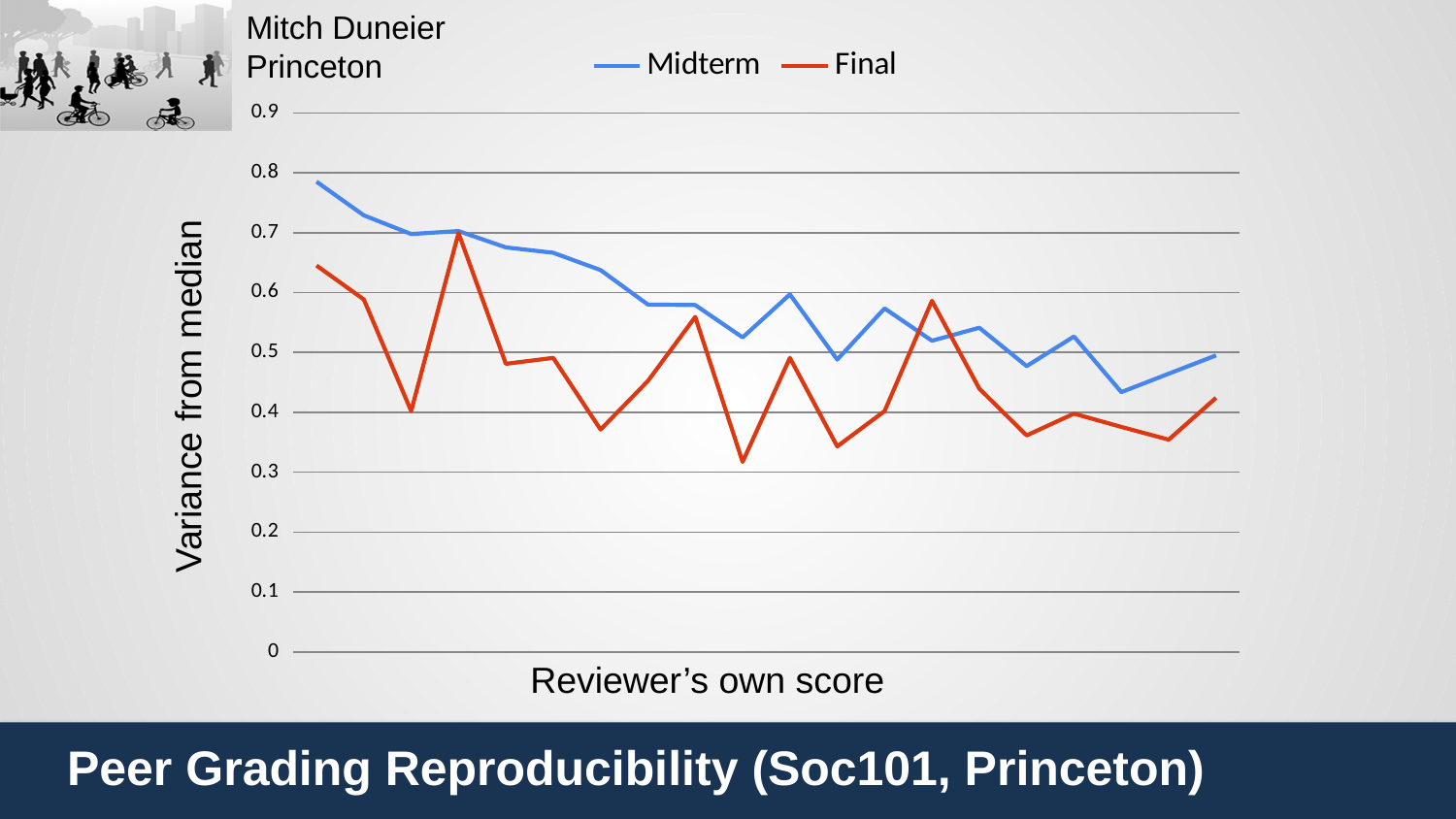
What kind of chart is shown on the slide? Line chart Which series reaches the highest value on the chart? Midterm Which series is drawn in red? Final Is the lowest value of the Final series greater or less than 0.4? less What are the two series named in the legend? Midterm and Final Is the leftmost value of the Final series greater or less than 0.6? greater Does the Midterm line generally rise or fall from left to right? Fall Is the rightmost value of the Midterm series greater or less than 0.4? greater How many series does the legend list? 2 What is the label on the vertical axis? Variance from median Which series has the higher value at the leftmost point, Midterm or Final? Midterm